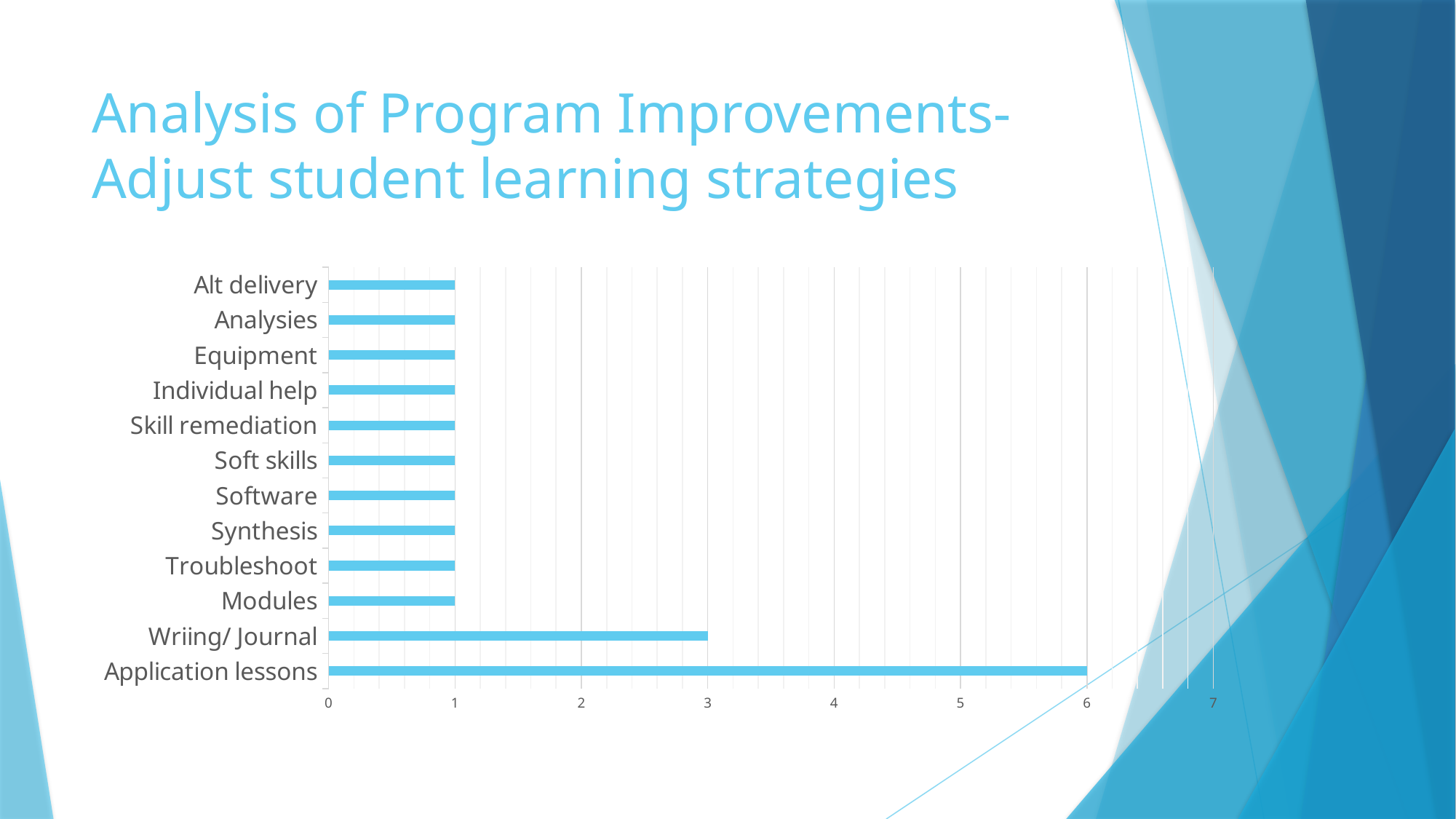
How many categories are plotted in the chart? 12 What is the value for Wriing/ Journal? 3 What is the value for Application lessons? 6 What kind of chart is shown on the slide? bar chart Which is larger, the value for Wriing/ Journal or the value for Software? Wriing/ Journal Is the value for Skill remediation greater or less than 2? less What is the value for Modules? 1 What is the value for Alt delivery? 1 Which category has the highest value? Application lessons What is the highest tick value shown on the horizontal axis? 7 What is the difference between the values for Application lessons and Wriing/ Journal? 3 Is the value for Application lessons greater or less than 5? greater